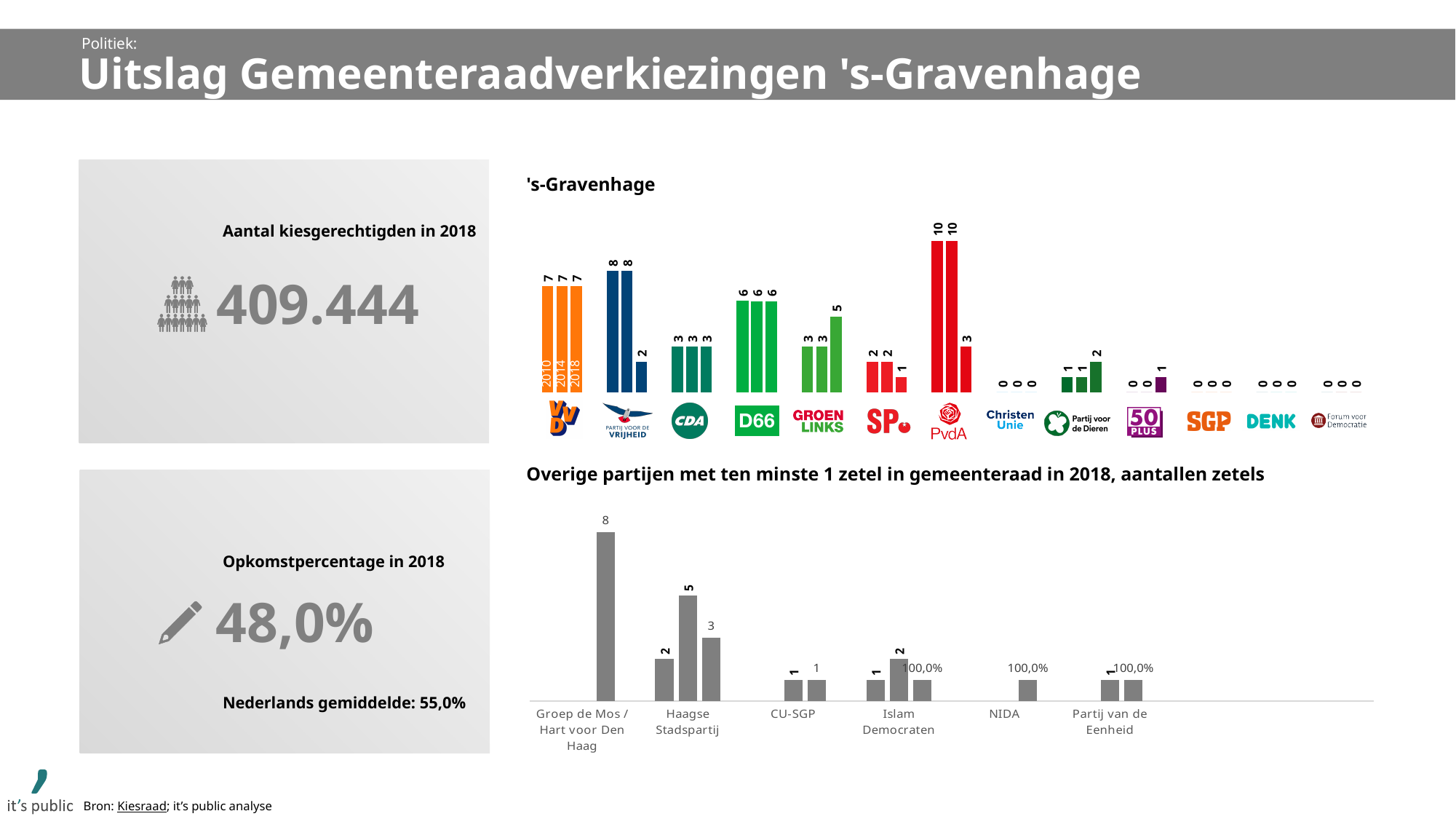
In the 's-Gravenhage chart, did the number of seats for SP rise or fall from 2014 to 2018? fall In the 's-Gravenhage chart, which party had more seats in 2018: VVD or D66? VVD What kind of chart is the 'Overige partijen met ten minste 1 zetel in gemeenteraad in 2018' chart? bar chart In the 's-Gravenhage chart, by how many seats did PvdA fall between 2014 and 2018? 7 In the 's-Gravenhage chart, how many seats did 50PLUS have in 2018? 1 In the 's-Gravenhage chart, which party had the most seats in 2014? PvdA In the chart 'Overige partijen met ten minste 1 zetel in gemeenteraad in 2018', how many seats does Groep de Mos / Hart voor Den Haag have? 8 In the 's-Gravenhage chart, how many years (series) are shown per party? 3 In the 's-Gravenhage chart, how many seats did GroenLinks have in 2018? 5 In the chart 'Overige partijen met ten minste 1 zetel in gemeenteraad in 2018', which party has the highest bar? Groep de Mos / Hart voor Den Haag In the 's-Gravenhage chart, how many seats did PVV (Partij voor de Vrijheid) have in 2018? 2 In the 's-Gravenhage chart, how many seats did PvdA have in 2010? 10